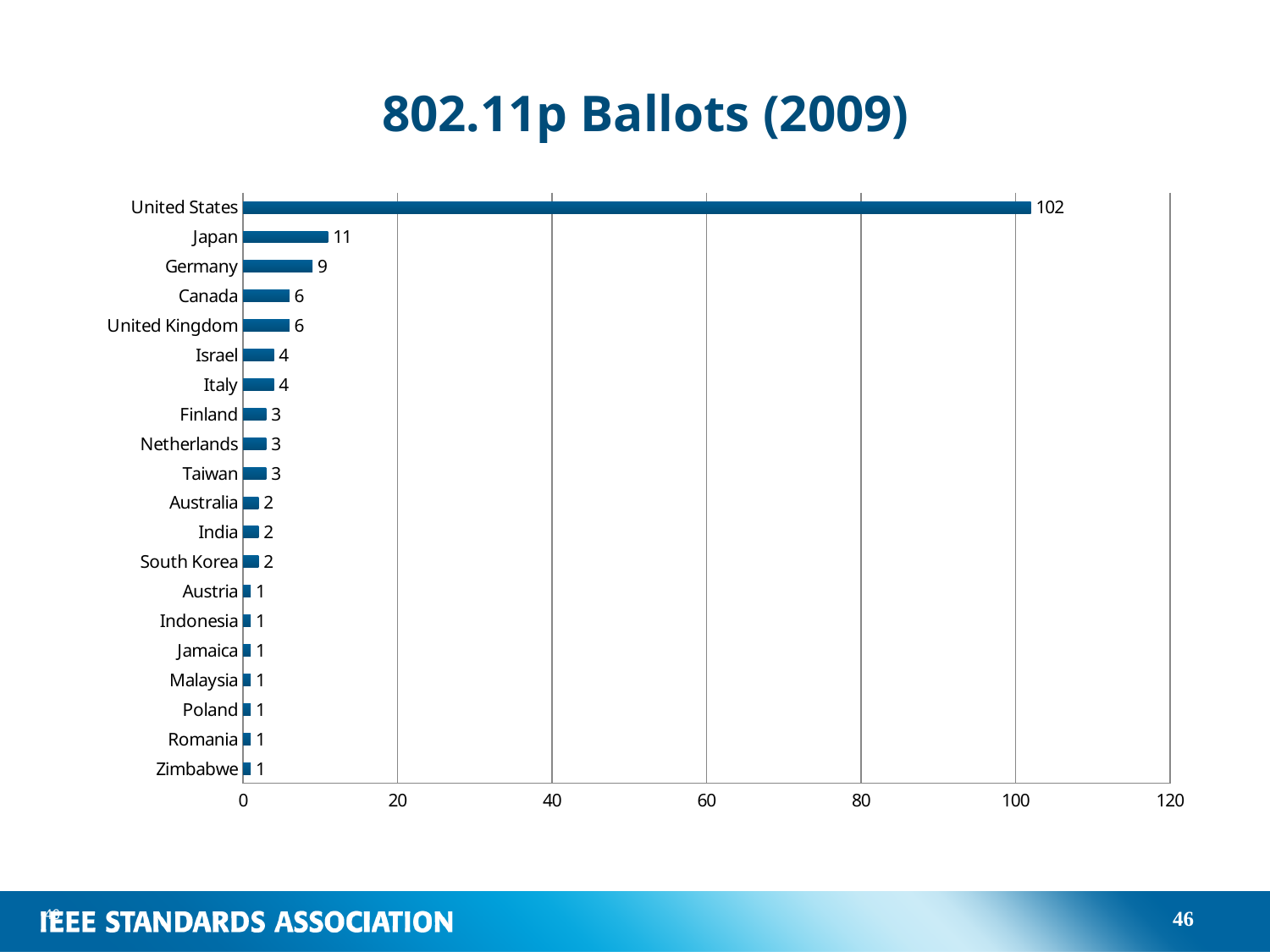
What is the difference between the values for the United States and Japan? 91 What is the value for Germany? 9 How many countries are shown in the chart? 20 What is the value for the United States? 102 Is the value for the United States greater or less than 100? greater What is the value for Japan? 11 What kind of chart is shown on the slide? bar chart What is the value for Taiwan? 3 Which country has the highest value? United States Which is larger, the value for Canada or the value for Israel? Canada What is the difference between the values for Japan and Germany? 2 What is the title of the chart? 802.11p Ballots (2009)